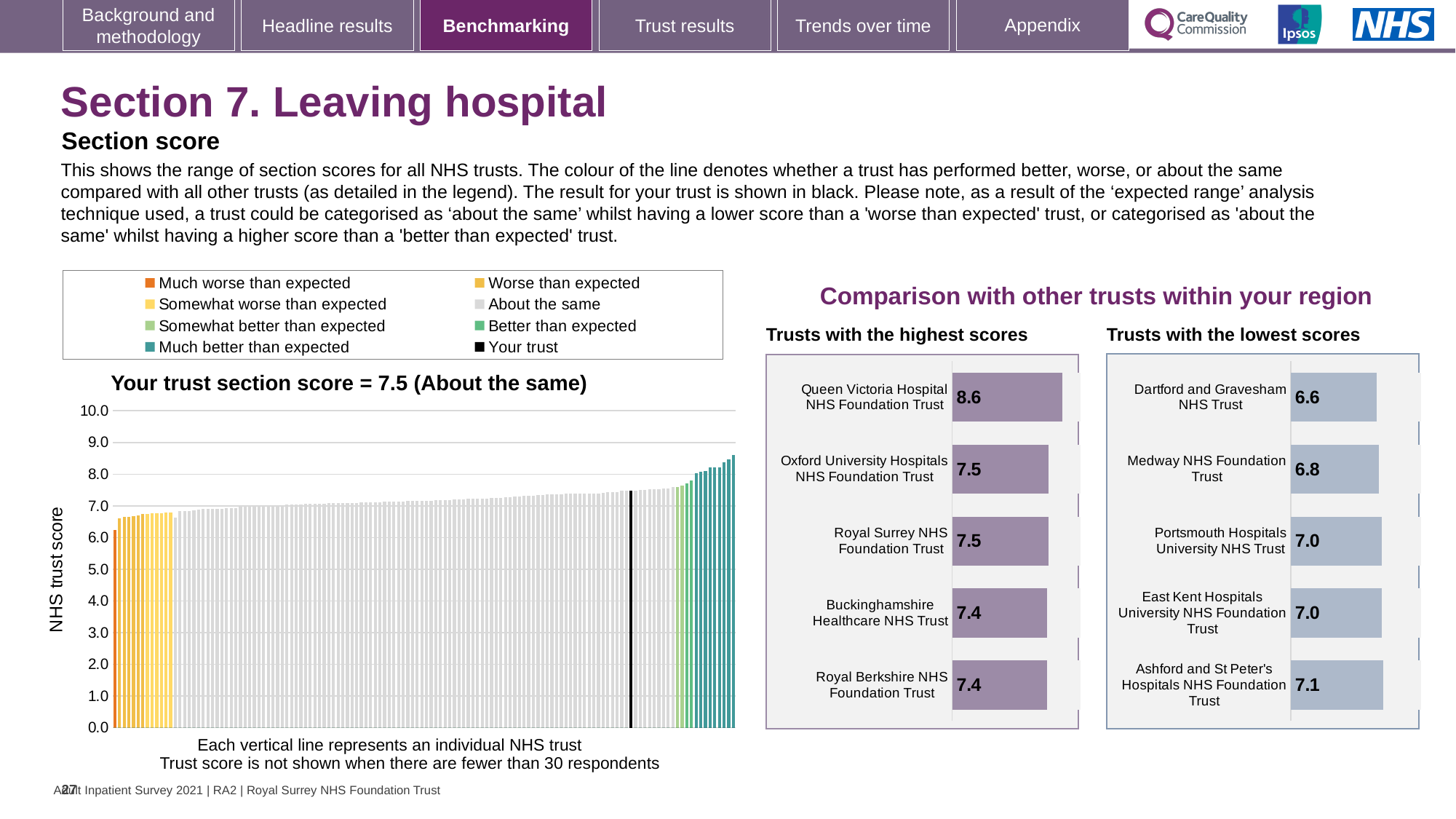
How many entries does the legend above the 'Your trust section score' chart list? 8 What kind of chart is the 'Your trust section score' chart on the left? bar chart In the 'Trusts with the lowest scores' chart, which trust has the lowest score? Dartford and Gravesham NHS Trust In the 'Trusts with the highest scores' chart, what is the score for Queen Victoria Hospital NHS Foundation Trust? 8.6 In the 'Your trust section score' chart on the left, what is the section score for your trust? 7.5 In the 'Trusts with the highest scores' chart, what is the difference between the scores of Queen Victoria Hospital NHS Foundation Trust and Royal Berkshire NHS Foundation Trust? 1.2 In the 'Your trust section score' chart, what colour is used for the bar representing your trust? Black In the 'Trusts with the lowest scores' chart, which has the larger score: Medway NHS Foundation Trust or Ashford and St Peter's Hospitals NHS Foundation Trust? Ashford and St Peter's Hospitals NHS Foundation Trust In the 'Trusts with the highest scores' chart, how many trusts are shown? 5 In the 'Trusts with the lowest scores' chart, what is the score for Medway NHS Foundation Trust? 6.8 In the 'Trusts with the lowest scores' chart, what is the difference between the scores of Ashford and St Peter's Hospitals NHS Foundation Trust and Dartford and Gravesham NHS Trust? 0.5 In the 'Trusts with the highest scores' chart, which trust has the highest score? Queen Victoria Hospital NHS Foundation Trust